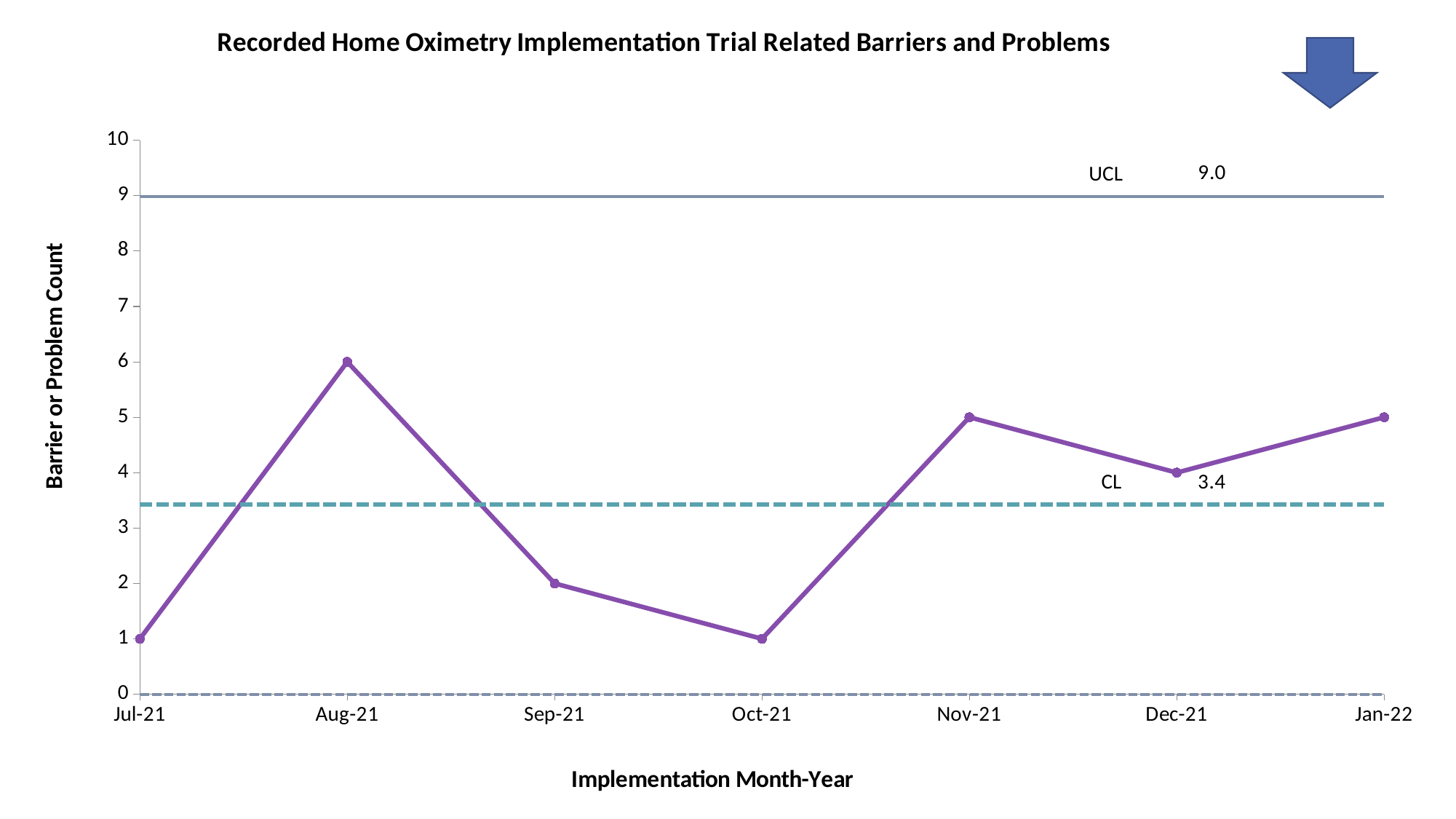
How many months are plotted on the x axis? 7 Is the barrier or problem count for Nov-21 greater or less than 3? greater What type of chart is shown on the slide? line chart What is the barrier or problem count for Oct-21? 1 What is the value of the CL line? 3.4 Which month has the highest barrier or problem count? Aug-21 What is the barrier or problem count for Dec-21? 4 What is the title of the chart? Recorded Home Oximetry Implementation Trial Related Barriers and Problems Which has a higher barrier or problem count, Nov-21 or Dec-21? Nov-21 What is the barrier or problem count for Aug-21? 6 What is the difference in barrier or problem count between Aug-21 and Sep-21? 4 What is the value of the UCL line? 9.0